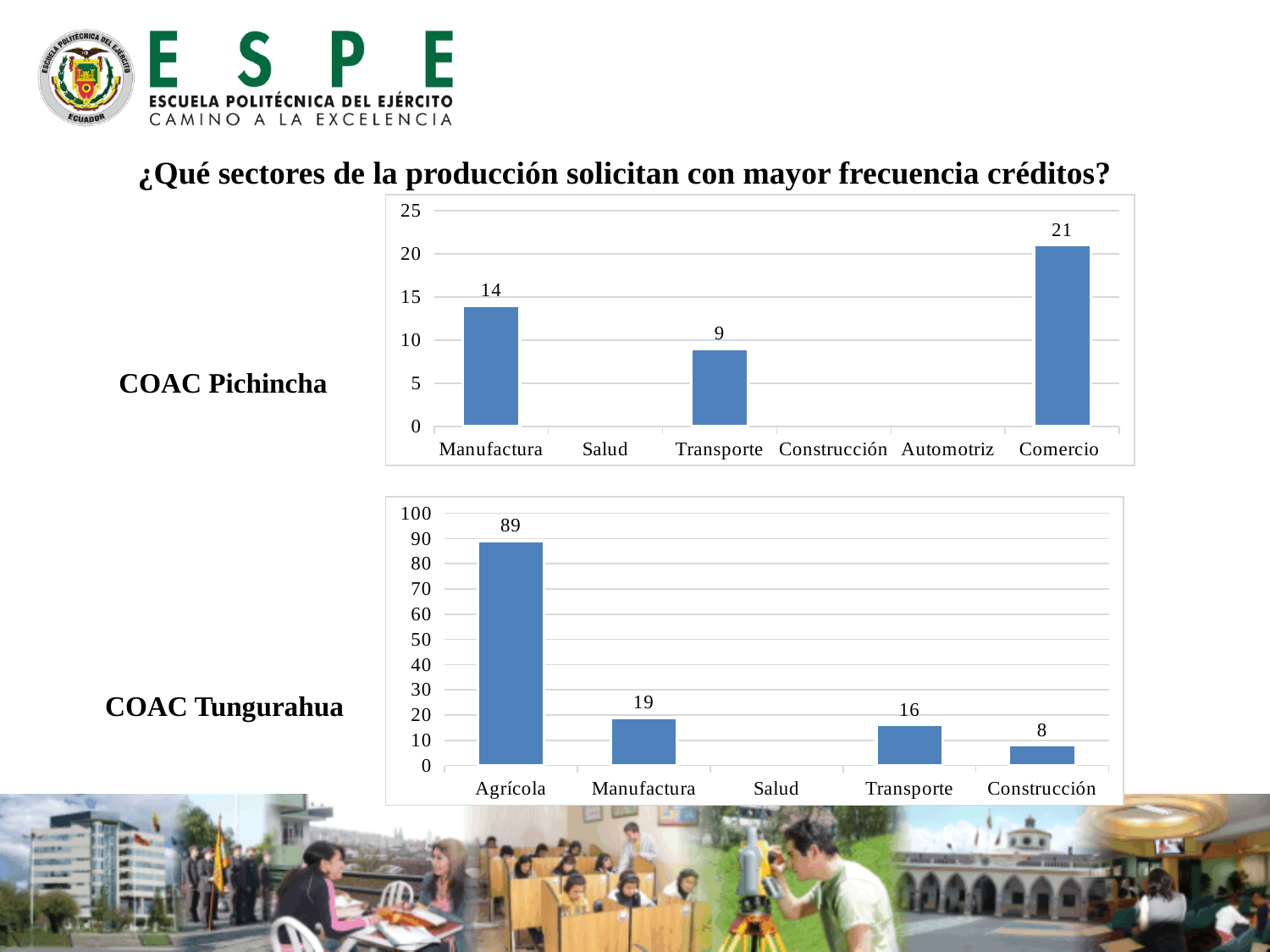
In the COAC Pichincha chart, which sector has the highest value? Comercio In the COAC Tungurahua chart, what is the difference between Agrícola and Manufactura? 70 In the COAC Tungurahua chart, which sector has the highest value? Agrícola In the COAC Tungurahua chart, which is larger, Manufactura or Transporte? Manufactura In the COAC Pichincha chart, what is the difference between Comercio and Manufactura? 7 In the COAC Pichincha chart, is the value for Manufactura greater or less than 10? greater In the COAC Tungurahua chart, what is the value for Agrícola? 89 In the COAC Tungurahua chart, what is the value for Construcción? 8 In the COAC Pichincha chart, how many sector categories are shown on the x axis? 6 In the COAC Pichincha chart, what is the value for Comercio? 21 What type of chart is the COAC Tungurahua chart? Bar chart In the COAC Pichincha chart, what is the value for Transporte? 9